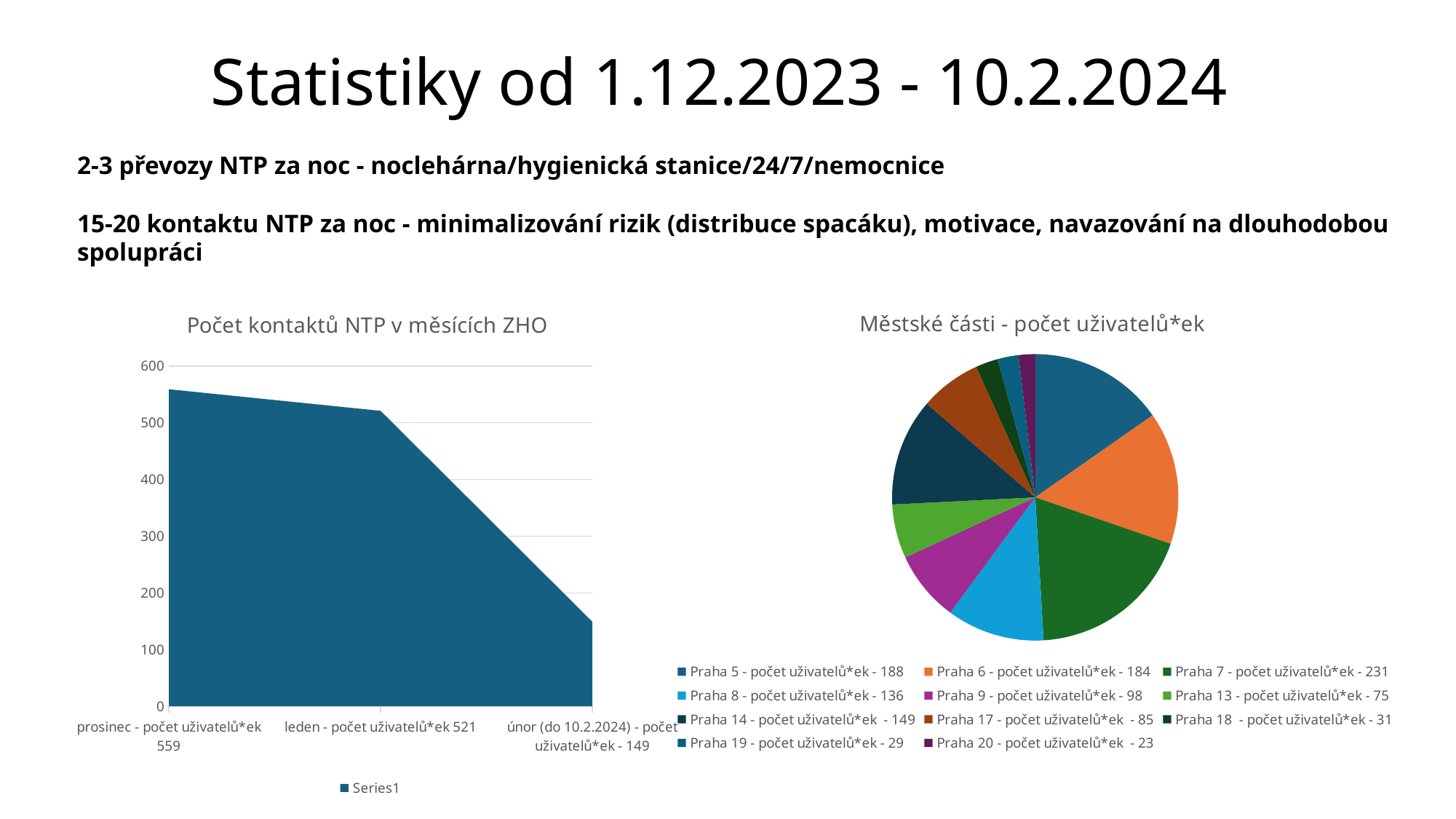
In the right pie chart 'Městské části - počet uživatelů*ek', which district has the highest number of users? Praha 7 In the left chart 'Počet kontaktů NTP v měsících ZHO', is the value for únor greater or less than 200? less In the right pie chart 'Městské části - počet uživatelů*ek', what is the number of users for Praha 8? 136 What kind of chart is the right chart titled 'Městské části - počet uživatelů*ek'? pie chart In the left chart 'Počet kontaktů NTP v měsících ZHO', do the values rise or fall from prosinec to únor? fall What kind of chart is the left chart titled 'Počet kontaktů NTP v měsících ZHO'? area chart In the left chart 'Počet kontaktů NTP v měsících ZHO', how many months (data points) are plotted? 3 In the right pie chart 'Městské části - počet uživatelů*ek', which district has the lowest number of users? Praha 20 In the left chart 'Počet kontaktů NTP v měsících ZHO', which month has the highest value? prosinec In the right pie chart 'Městské části - počet uživatelů*ek', how many city districts are listed in the legend? 11 In the left chart 'Počet kontaktů NTP v měsících ZHO', what is the number of users for leden? 521 In the left chart 'Počet kontaktů NTP v měsících ZHO', what is the difference between the values for prosinec and leden? 38